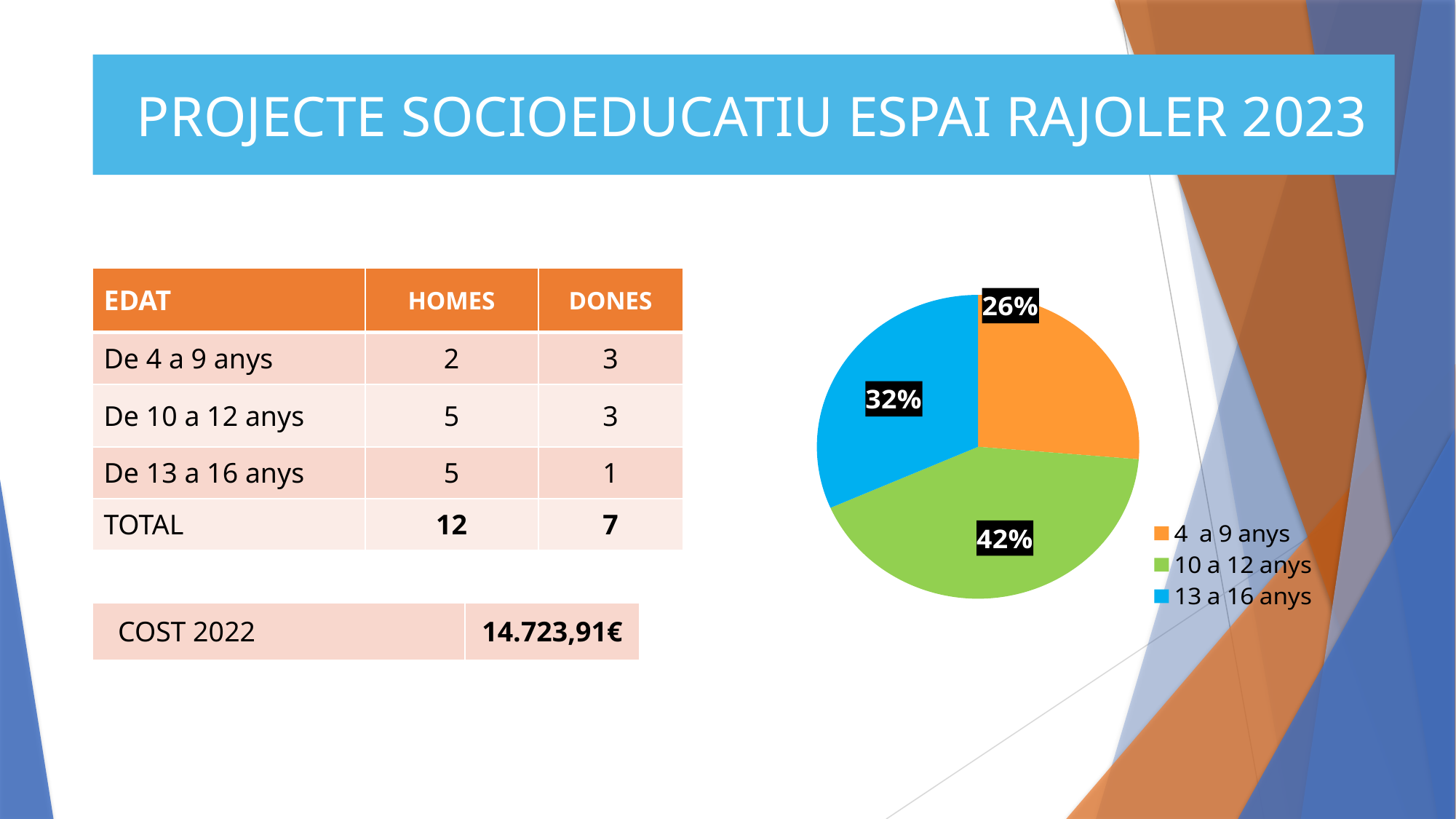
What percentage of the pie chart does the '13 a 16 anys' slice represent? 32% What percentage of the pie chart does the '10 a 12 anys' slice represent? 42% Which age group has the largest slice in the pie chart? 10 a 12 anys What percentage of the pie chart does the '4 a 9 anys' slice represent? 26% Which age group has the smallest slice in the pie chart? 4 a 9 anys What colour is the '10 a 12 anys' slice in the pie chart? green What is the difference in percentage points between the '10 a 12 anys' slice and the '4 a 9 anys' slice? 16 What colour is the '13 a 16 anys' slice in the pie chart? blue Which slice is larger in the pie chart: '13 a 16 anys' or '4 a 9 anys'? 13 a 16 anys What type of chart is shown on the slide? pie chart How many slices does the pie chart have? 3 How many entries does the pie chart legend list? 3